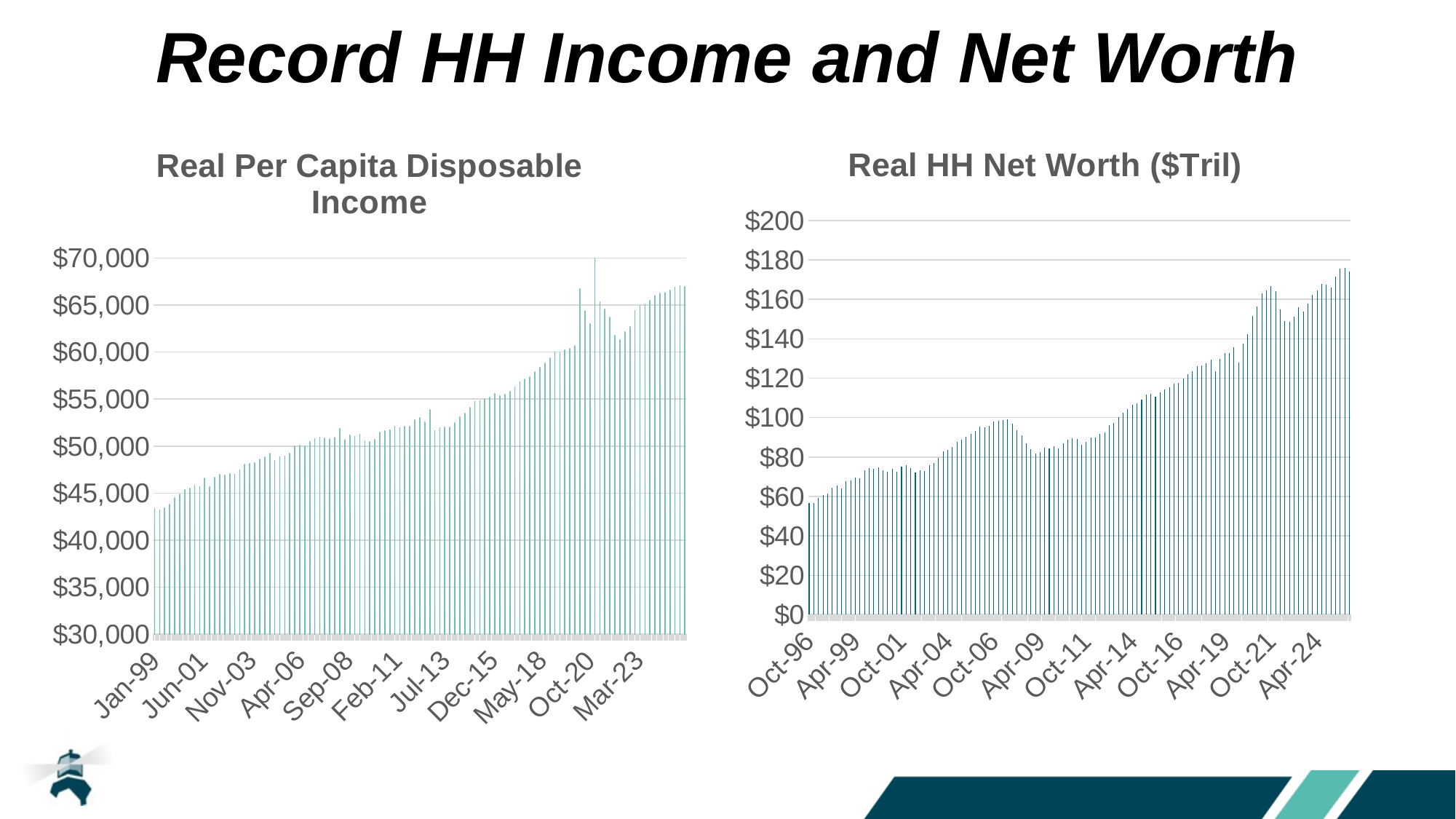
What is the title of the chart on the right side of the slide? Real HH Net Worth ($Tril) In the 'Real HH Net Worth ($Tril)' chart, which is larger, the value for Oct-96 or the value for Apr-24? Apr-24 What kind of chart is the 'Real Per Capita Disposable Income' chart on the left? Bar chart In the 'Real Per Capita Disposable Income' chart, do the values generally rise or fall from Jan-99 to the end of the series? Rise In the 'Real HH Net Worth ($Tril)' chart, is the value for Apr-09 greater or less than $100? less What kind of chart is the 'Real HH Net Worth ($Tril)' chart on the right? Bar chart In the 'Real HH Net Worth ($Tril)' chart, is the value for Oct-96 greater or less than $80? less In the 'Real Per Capita Disposable Income' chart, is the value for Jan-99 greater or less than $45,000? less In the 'Real HH Net Worth ($Tril)' chart, do the values generally rise or fall from Oct-96 to Apr-24? Rise In the 'Real Per Capita Disposable Income' chart, which is larger, the value for Jan-99 or the value for Mar-23? Mar-23